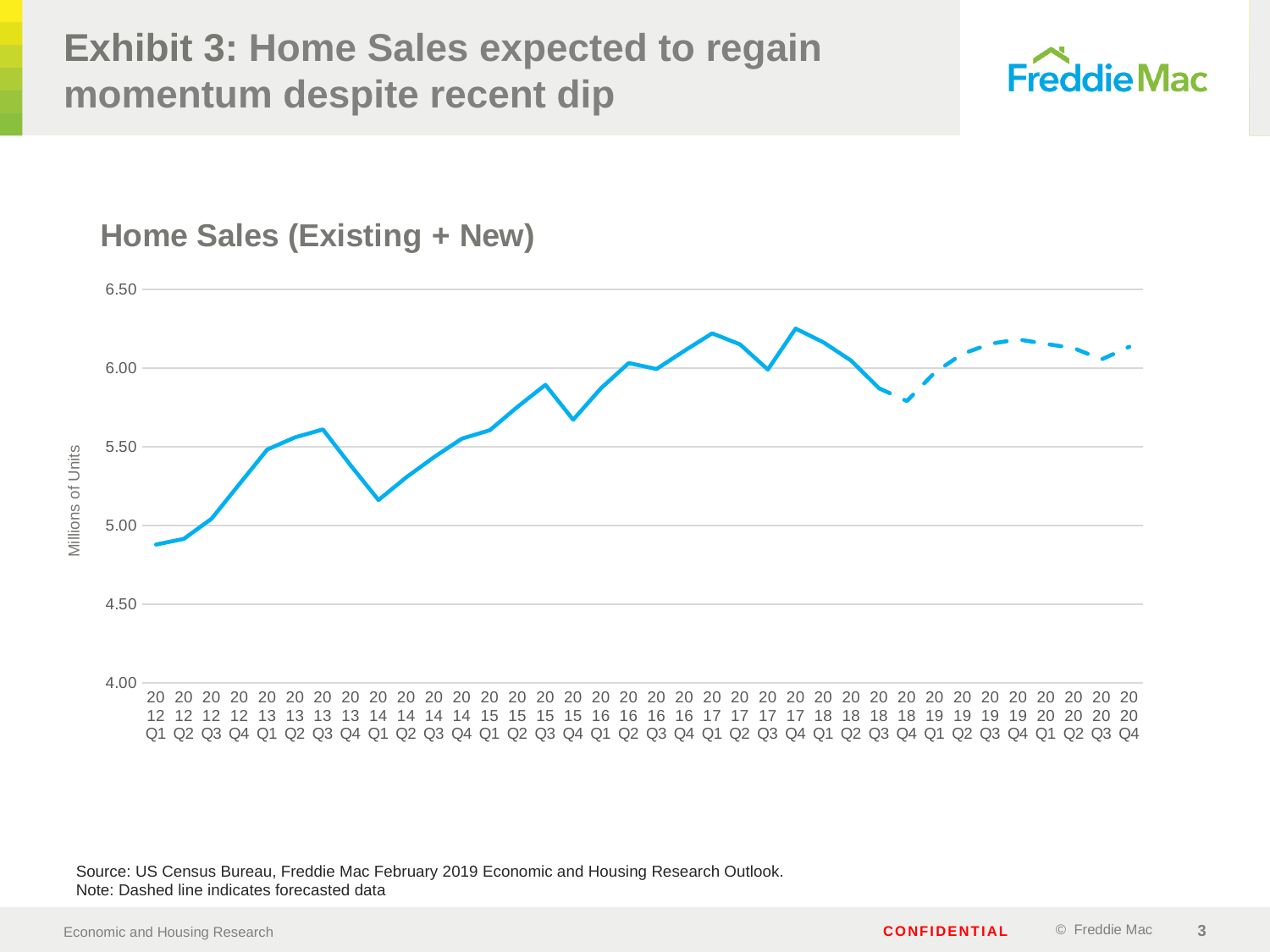
Is the value for 2013 Q3 greater or less than 5.50? greater Is the value for 2017 Q4 greater or less than 6.00? greater Is the value for 2015 Q4 greater or less than 6.00? less What is the title of the chart? Home Sales (Existing + New) Do the values rise or fall from 2012 Q1 to 2013 Q3? rise What kind of chart is shown on the slide? line chart What does the dashed portion of the line indicate, according to the note? forecasted data Which quarter has the lowest value on the chart? 2012 Q1 Which is larger, the value for 2013 Q3 or the value for 2014 Q1? 2013 Q3 How many quarters are plotted along the x axis? 36